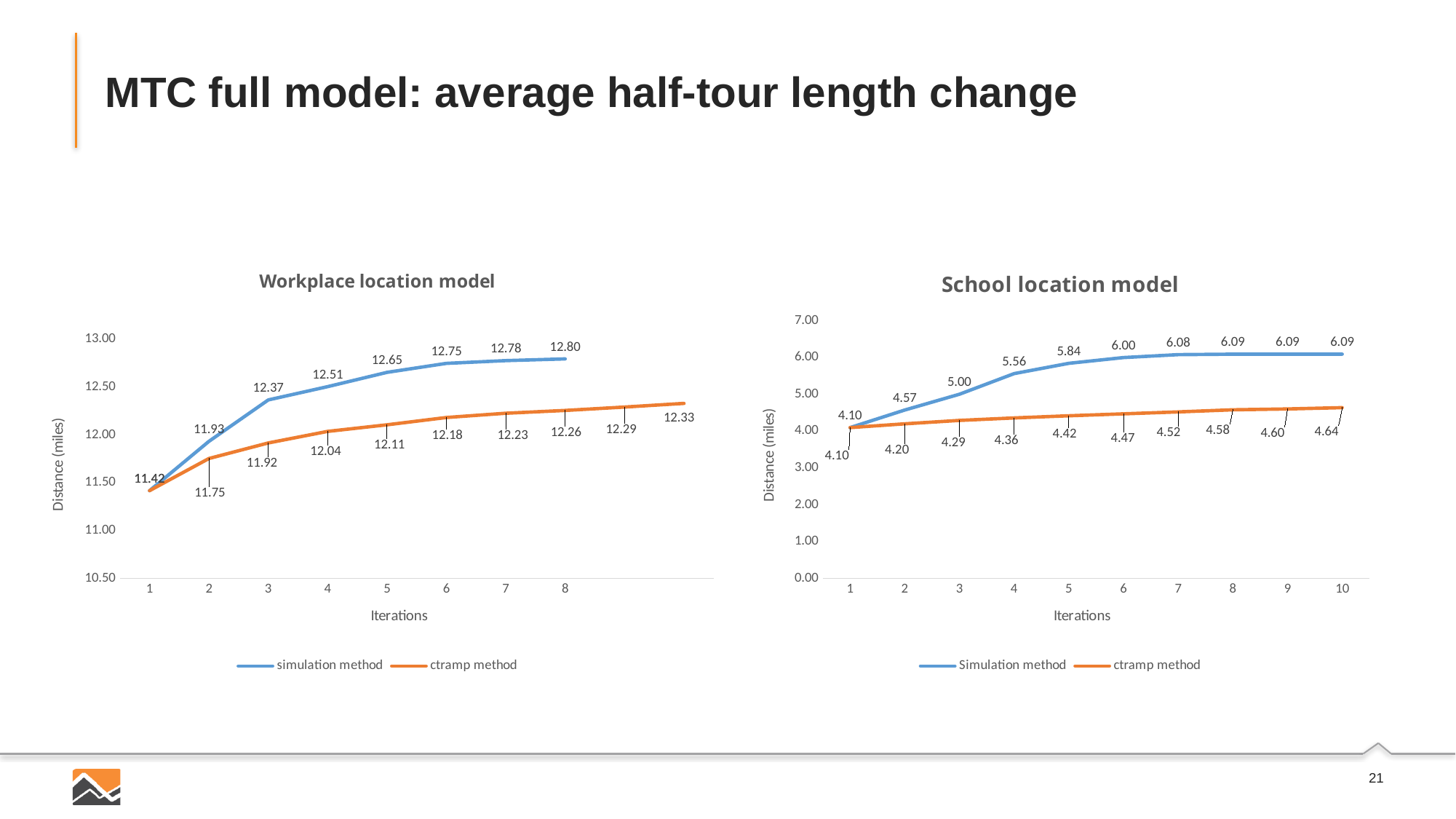
In the Workplace location model chart, which series has the larger value at iteration 4, simulation method or ctramp method? simulation method In the Workplace location model chart, what is the difference between the simulation method and ctramp method values at iteration 5? 0.54 In the School location model chart, what is the ctramp method value at iteration 10? 4.64 In the Workplace location model chart, what is the simulation method value at iteration 3? 12.37 How many series does the legend of the School location model chart list? 2 In the Workplace location model chart, at which iteration does the simulation method reach its highest value? 8 How many iterations are labelled on the x axis of the School location model chart? 10 In the School location model chart, does the Simulation method line rise or fall as iterations increase? rise In the Workplace location model chart, what is the simulation method value at iteration 8? 12.80 In the School location model chart, what is the difference between the Simulation method and ctramp method values at iteration 10? 1.45 In the School location model chart, what is the Simulation method value at iteration 4? 5.56 What kind of chart is the Workplace location model chart? line chart